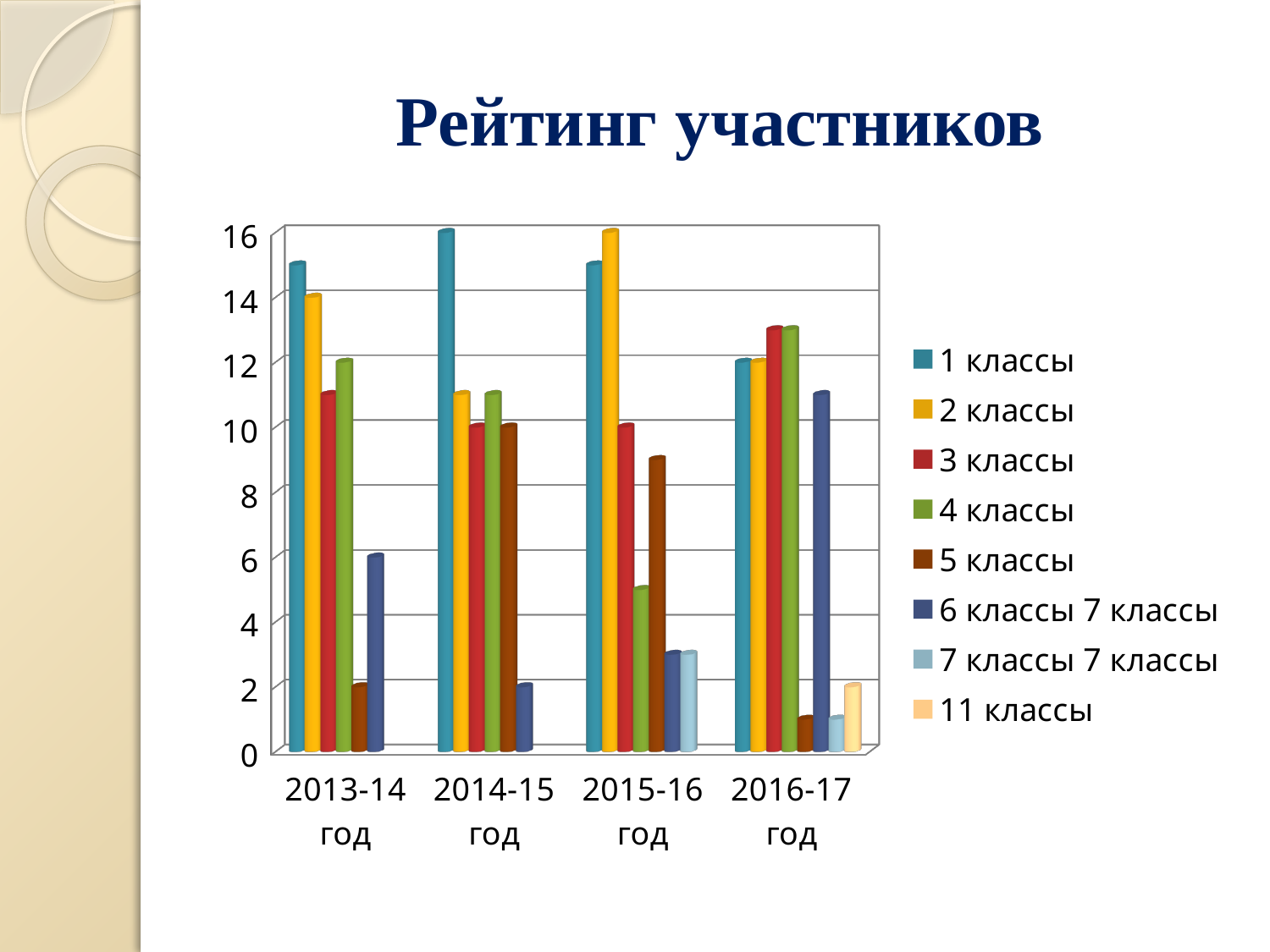
Which is larger: the value for 5 классы in 2013-14 год or in 2015-16 год? 2015-16 год Is the value for 4 классы in 2015-16 год greater or less than 6? less Is the value for 6 классы in 2013-14 год greater or less than 8? less What is the title of the chart? Рейтинг участников Which series has the lowest bar in 2014-15 год? 6 классы 7 классы Is the value for 5 классы in 2015-16 год greater or less than 8? greater Which series has the highest bar in 2015-16 год? 2 классы Which is larger: the value for 1 классы in 2013-14 год or in 2016-17 год? 2013-14 год How many series does the legend list? 8 Which series has the highest bar in 2014-15 год? 1 классы How many year categories are shown on the x axis? 4 What kind of chart is shown on the slide? bar chart